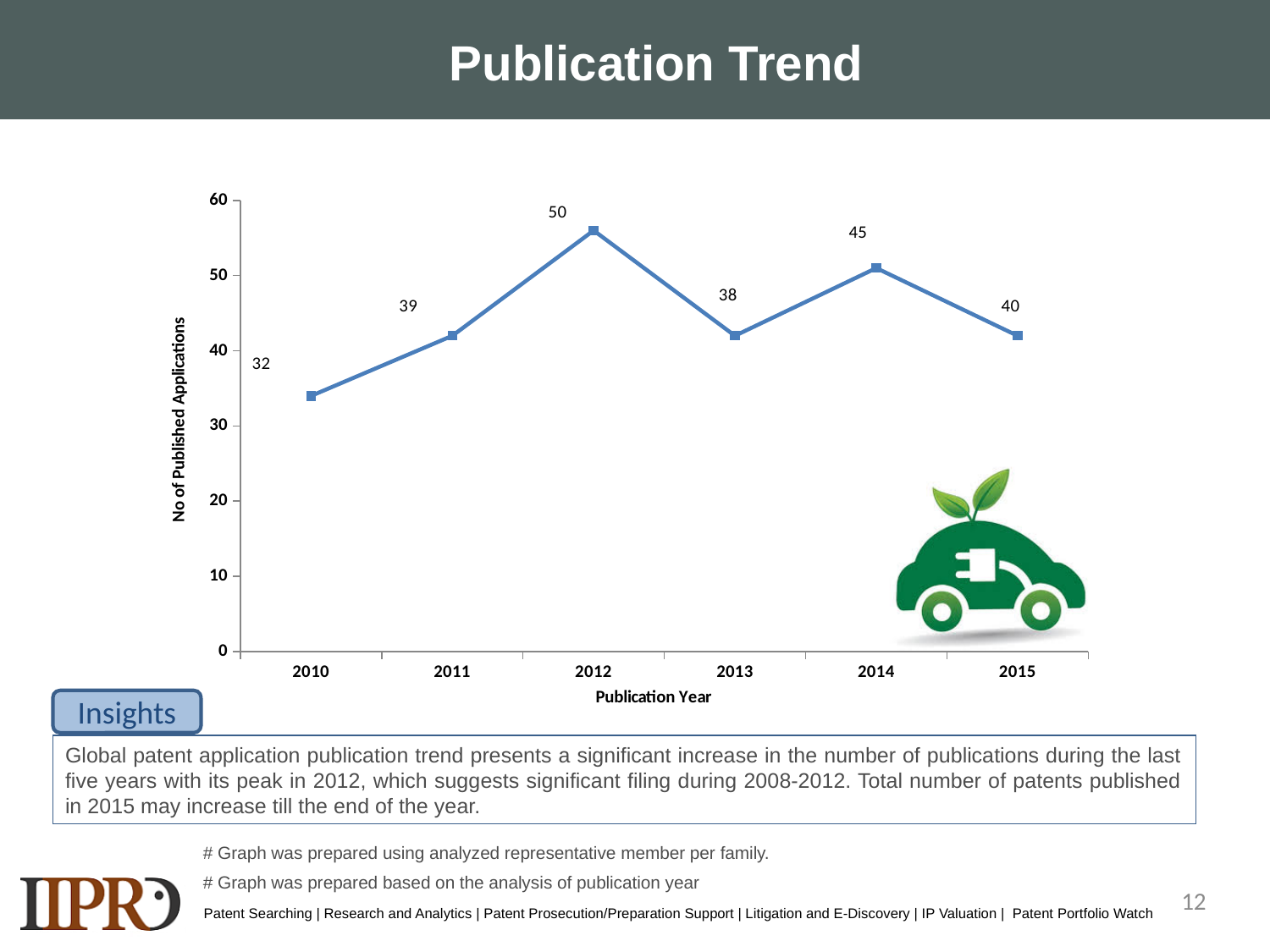
What is the difference between the number of published applications in 2012 and 2013? 12 What is the number of published applications in 2012? 50 What is the number of published applications in 2014? 45 Which publication year has the lowest number of published applications? 2010 Which publication year has the highest number of published applications? 2012 What kind of chart is shown on the slide? Line chart What is the label of the vertical axis of the chart? No of Published Applications Which year has more published applications, 2011 or 2014? 2014 Is the value for 2015 greater or less than 30? greater Do the values rise or fall from 2010 to 2012? Rise How many publication years are plotted on the chart? 6 What is the number of published applications in 2010? 32